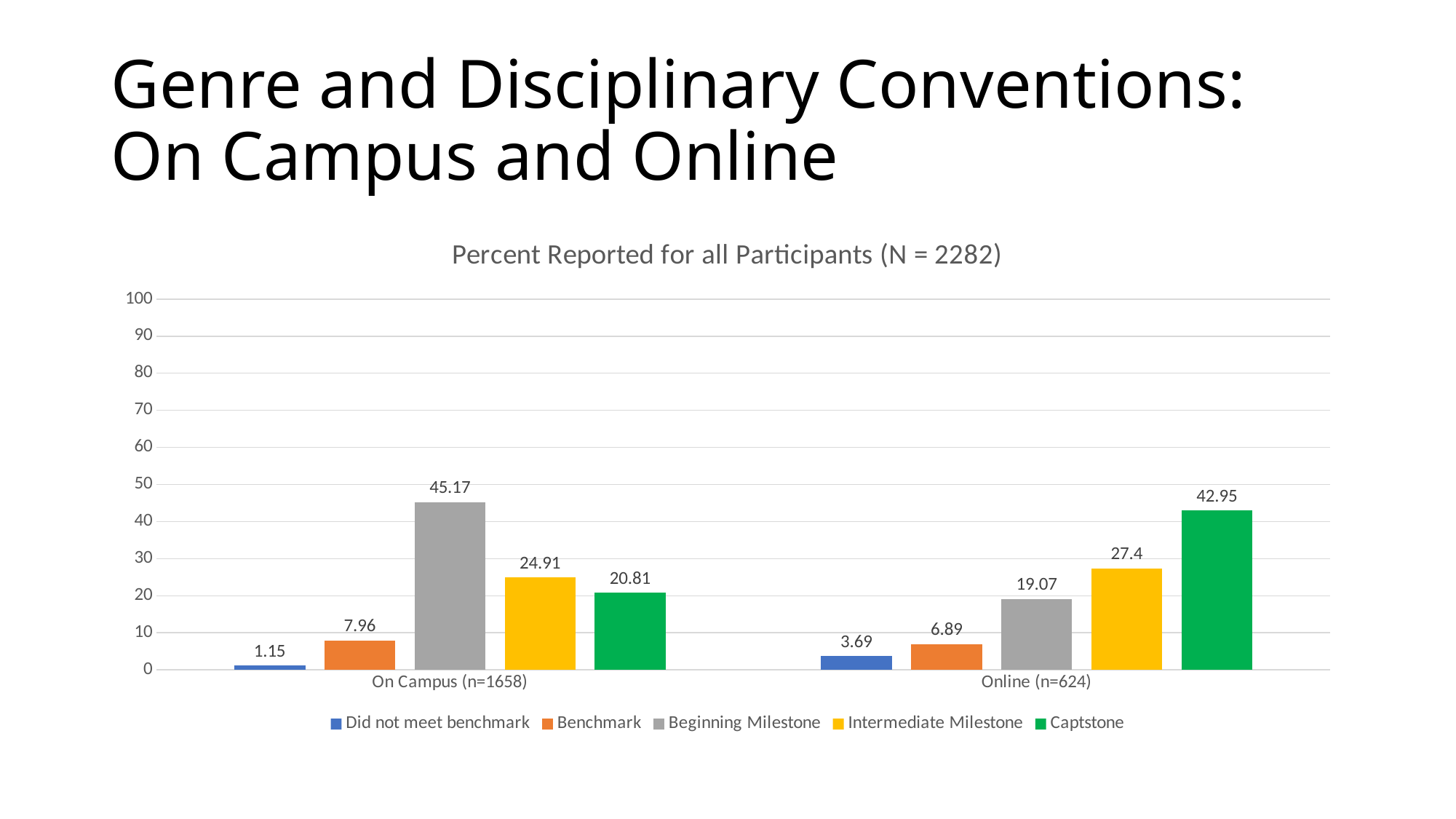
What is the value for Did not meet benchmark in the Online (n=624) group? 3.69 How many categories are shown on the x axis? 2 Is the value for Beginning Milestone in the Online (n=624) group greater or less than 20? less Which series has the highest value in the On Campus (n=1658) group? Beginning Milestone What is the difference between the Intermediate Milestone values for Online (n=624) and On Campus (n=1658)? 2.49 What is the value for Beginning Milestone in the On Campus (n=1658) group? 45.17 How many series does the legend list? 5 Which series has the lowest value in the Online (n=624) group? Did not meet benchmark What kind of chart is shown on the slide? bar chart What is the title of the chart? Percent Reported for all Participants (N = 2282) Which is larger: Captstone for On Campus (n=1658) or Captstone for Online (n=624)? Online (n=624) What is the value for Captstone in the Online (n=624) group? 42.95